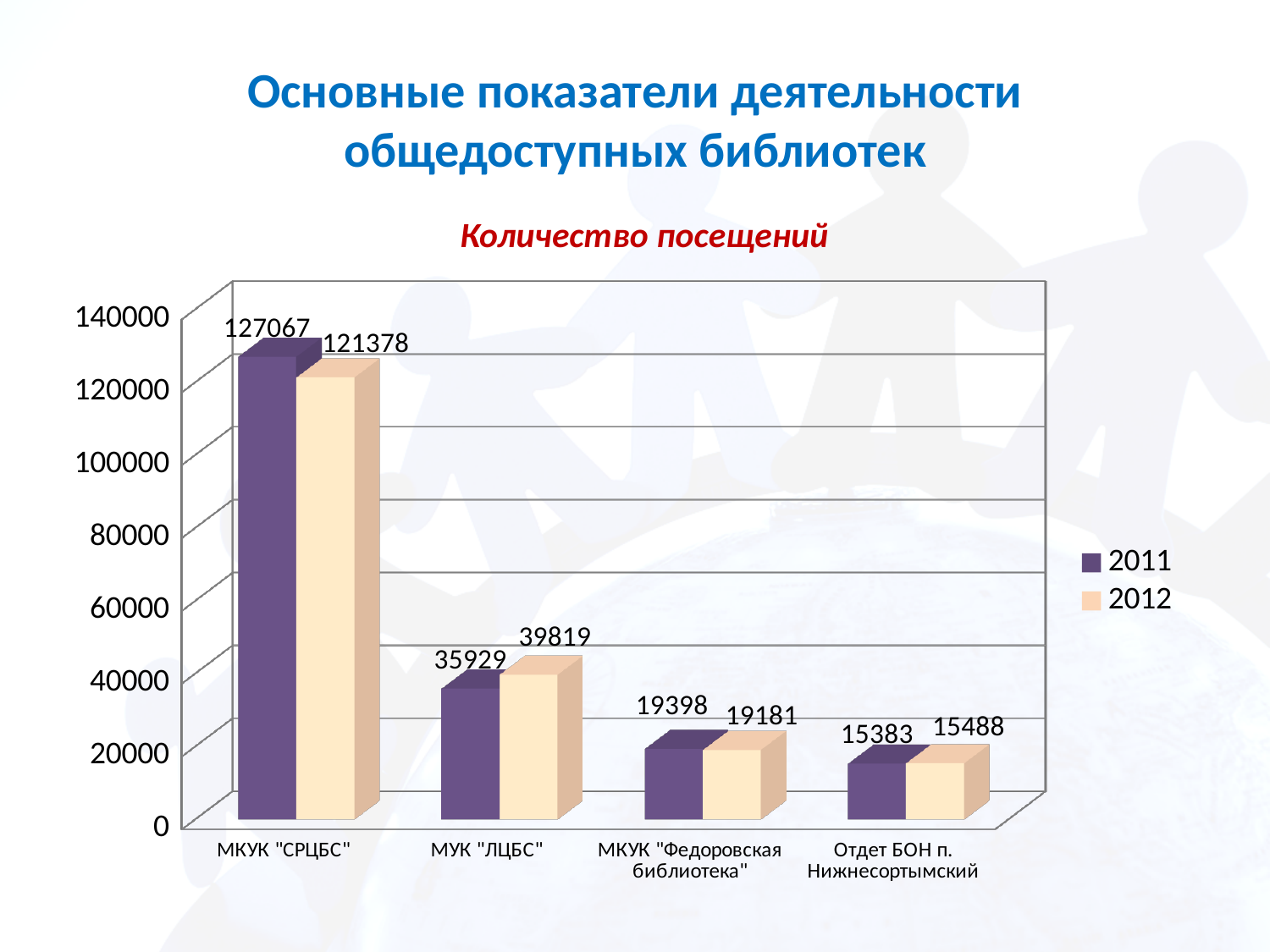
Is the 2011 value for МУК "ЛЦБС" greater or less than 40000? less What is the difference between the 2011 and 2012 values for МКУК "СРЦБС"? 5689 How many series does the legend list? 2 Which category has the lowest 2011 value? Отдет БОН п. Нижнесортымский What is the 2011 value for МКУК "СРЦБС"? 127067 What kind of chart is shown on the slide? bar chart What is the 2012 value for МУК "ЛЦБС"? 39819 How many categories are shown on the x axis? 4 What is the 2012 value for МКУК "Федоровская библиотека"? 19181 What is the 2011 value for Отдет БОН п. Нижнесортымский? 15383 For МУК "ЛЦБС", which year has the larger value, 2011 or 2012? 2012 Which category has the highest 2012 value? МКУК "СРЦБС"